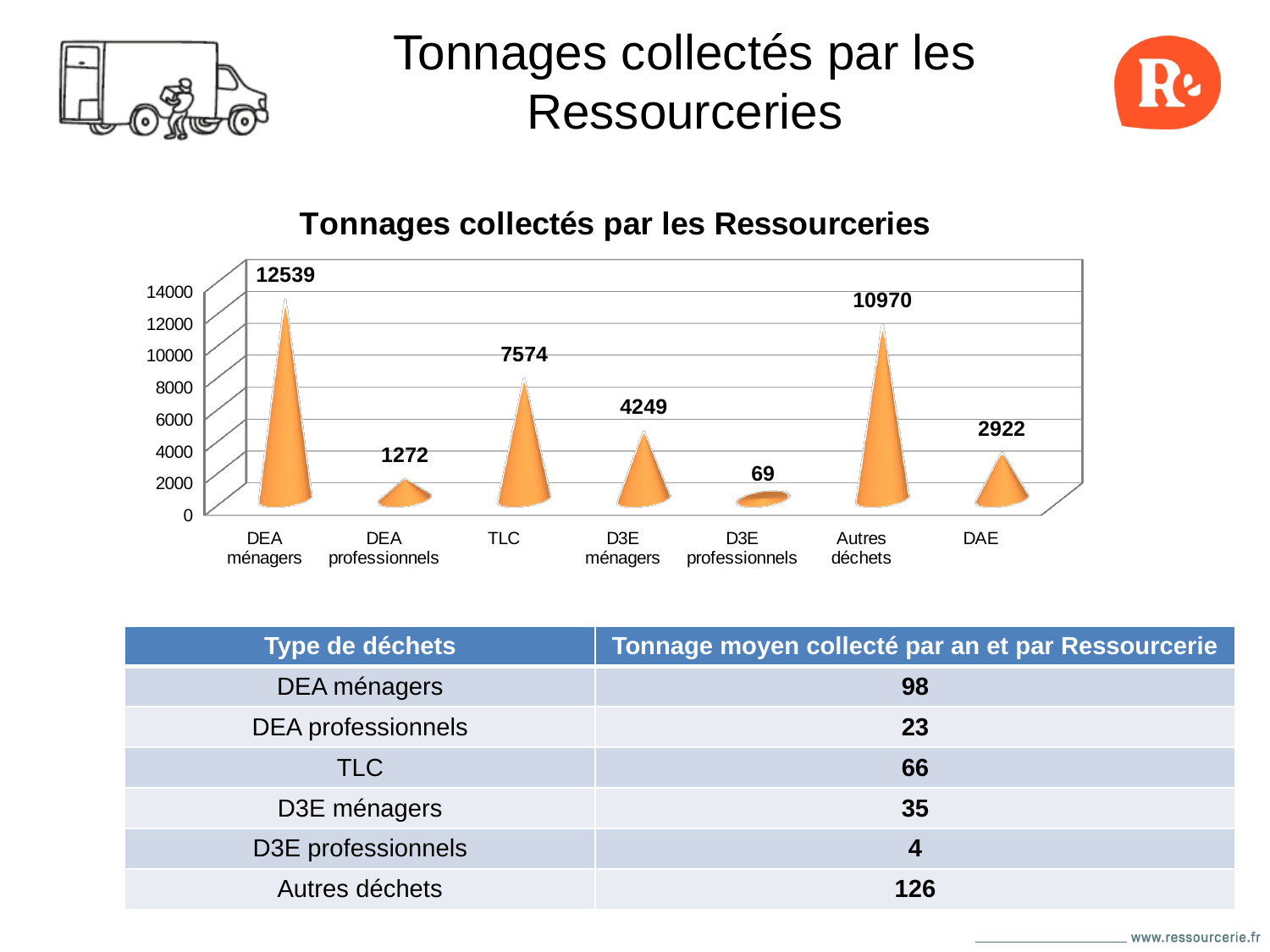
Which is larger, the value for DEA professionnels or the value for DAE? DAE Which category has the lowest value? D3E professionnels What is the title of the chart? Tonnages collectés par les Ressourceries What is the value for Autres déchets? 10970 Which category has the highest value? DEA ménagers What kind of chart is shown? bar chart What is the value for DAE? 2922 How many categories are shown on the x axis? 7 What is the difference between the values for TLC and D3E ménagers? 3325 What is the value for DEA ménagers? 12539 What is the value for D3E professionnels? 69 Is the value for TLC greater or less than 6000? greater